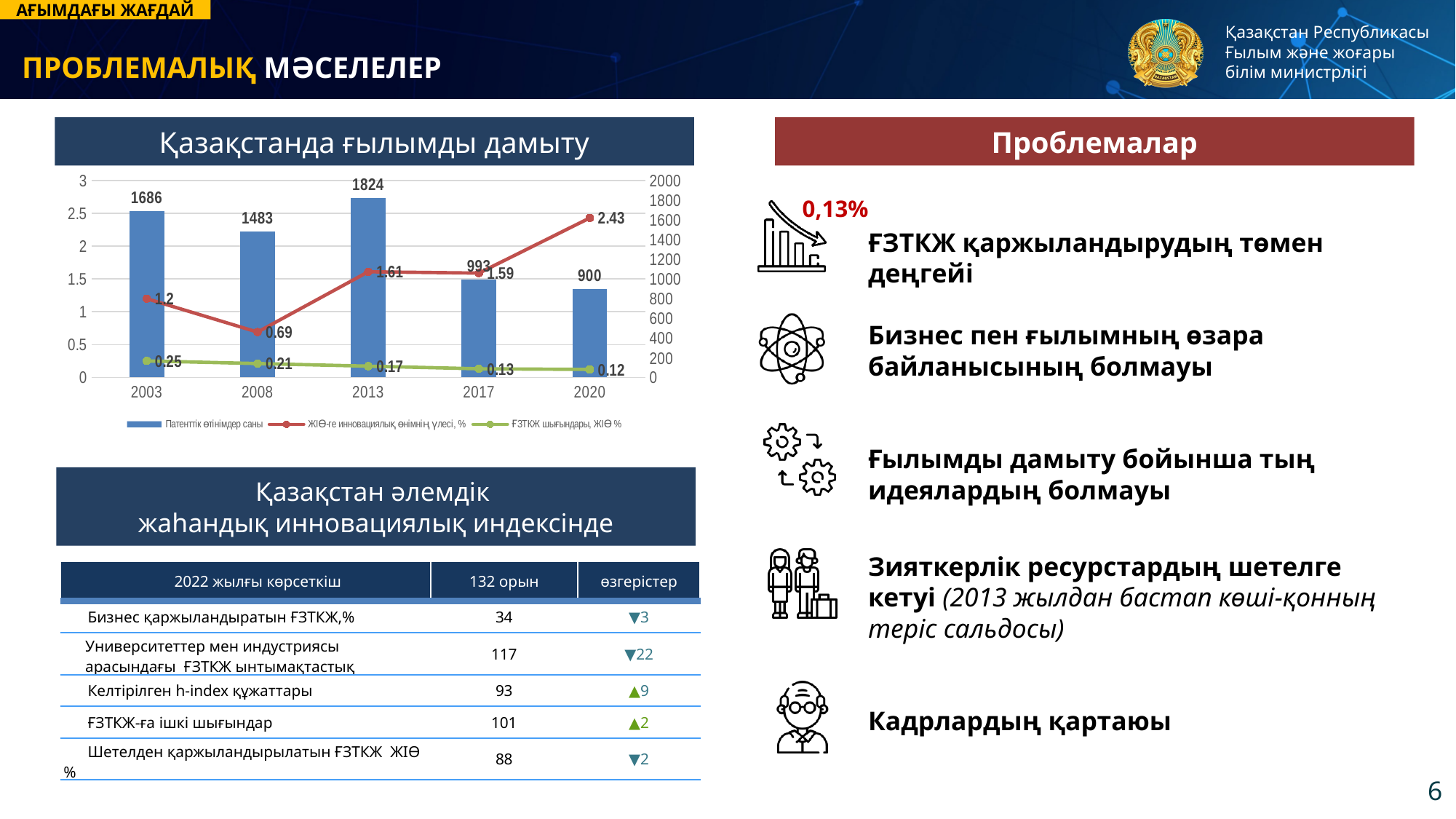
In the chart 'Қазақстанда ғылымды дамыту', what is the value of ҒЗТКЖ шығындары, ЖІӨ % in 2020? 0.12 In the chart 'Қазақстанда ғылымды дамыту', which year has the lowest number of patent applications? 2020 In the chart 'Қазақстанда ғылымды дамыту', what colour is the line for ЖІӨ-ге инновациялық өнімнің үлесі, %? Red In the chart 'Қазақстанда ғылымды дамыту', which year has the highest number of patent applications? 2013 How many series does the legend of the chart 'Қазақстанда ғылымды дамыту' list? 3 In the chart 'Қазақстанда ғылымды дамыту', what is the value of ЖІӨ-ге инновациялық өнімнің үлесі, % in 2008? 0.69 In the chart 'Қазақстанда ғылымды дамыту', what is the number of patent applications (Патенттік өтінімдер саны) in 2013? 1824 What type of chart is used in 'Қазақстанда ғылымды дамыту'? Combined bar and line chart How many years are shown on the x axis of the chart 'Қазақстанда ғылымды дамыту'? 5 In the chart 'Қазақстанда ғылымды дамыту', how does ҒЗТКЖ шығындары, ЖІӨ % change from 2003 to 2020? It falls In the chart 'Қазақстанда ғылымды дамыту', which is larger: the share of innovative products in GDP in 2013 or in 2020? 2020 In the chart 'Қазақстанда ғылымды дамыту', what is the difference in patent applications between 2003 and 2008? 203